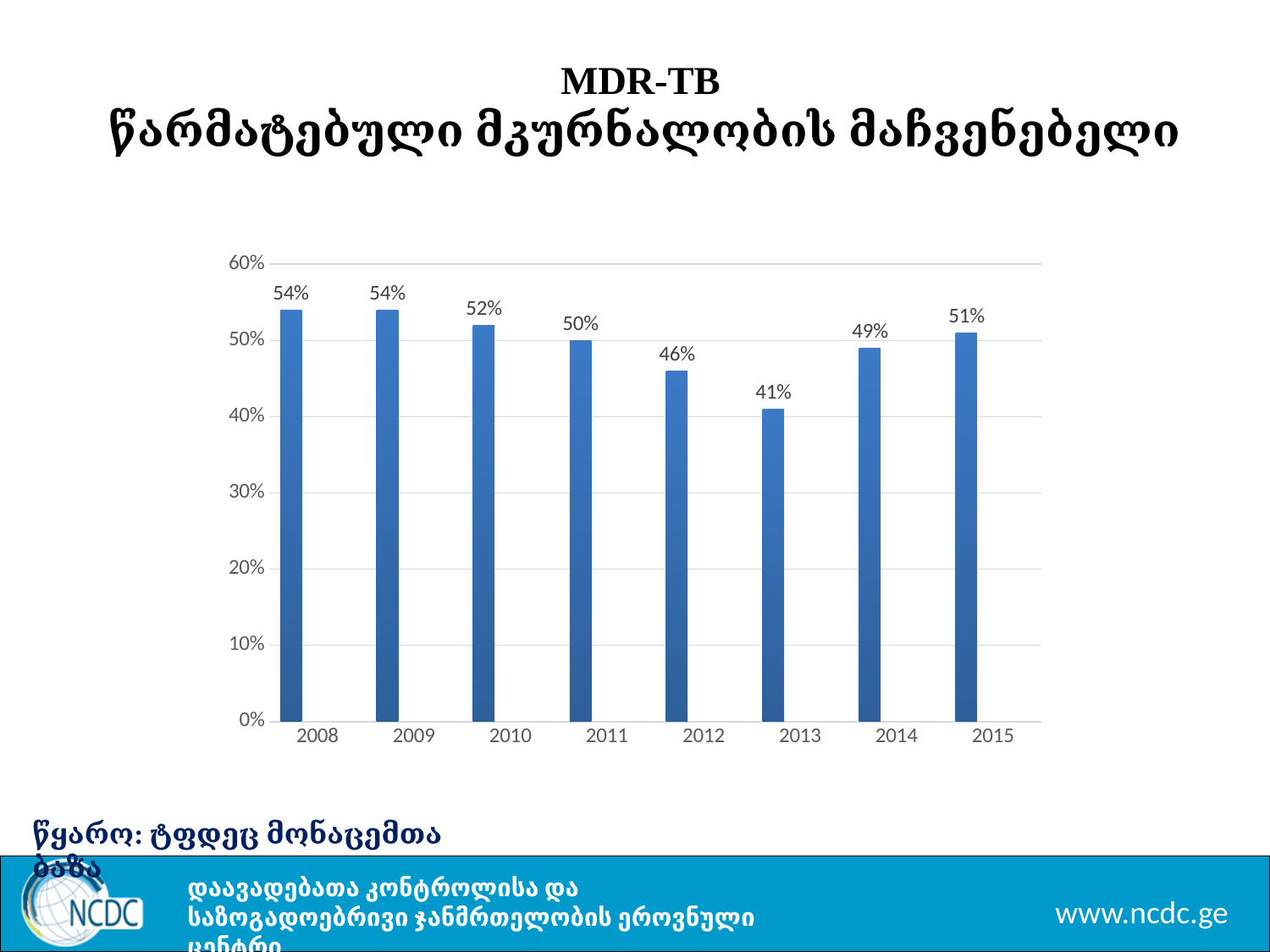
What is the value for 2013? 41% What kind of chart is this? bar chart What is the difference between the values for 2008 and 2013? 13% How many years are shown on the x axis? 8 What is the value for 2015? 51% Is the value for 2012 greater or less than 50%? less Do the values rise or fall from 2008 to 2013? fall Which year has the lowest value? 2013 Which is larger, the value for 2012 or the value for 2014? 2014 What is the difference between the values for 2014 and 2015? 2% What is the highest value shown on the y axis? 60% What is the value for 2011? 50%